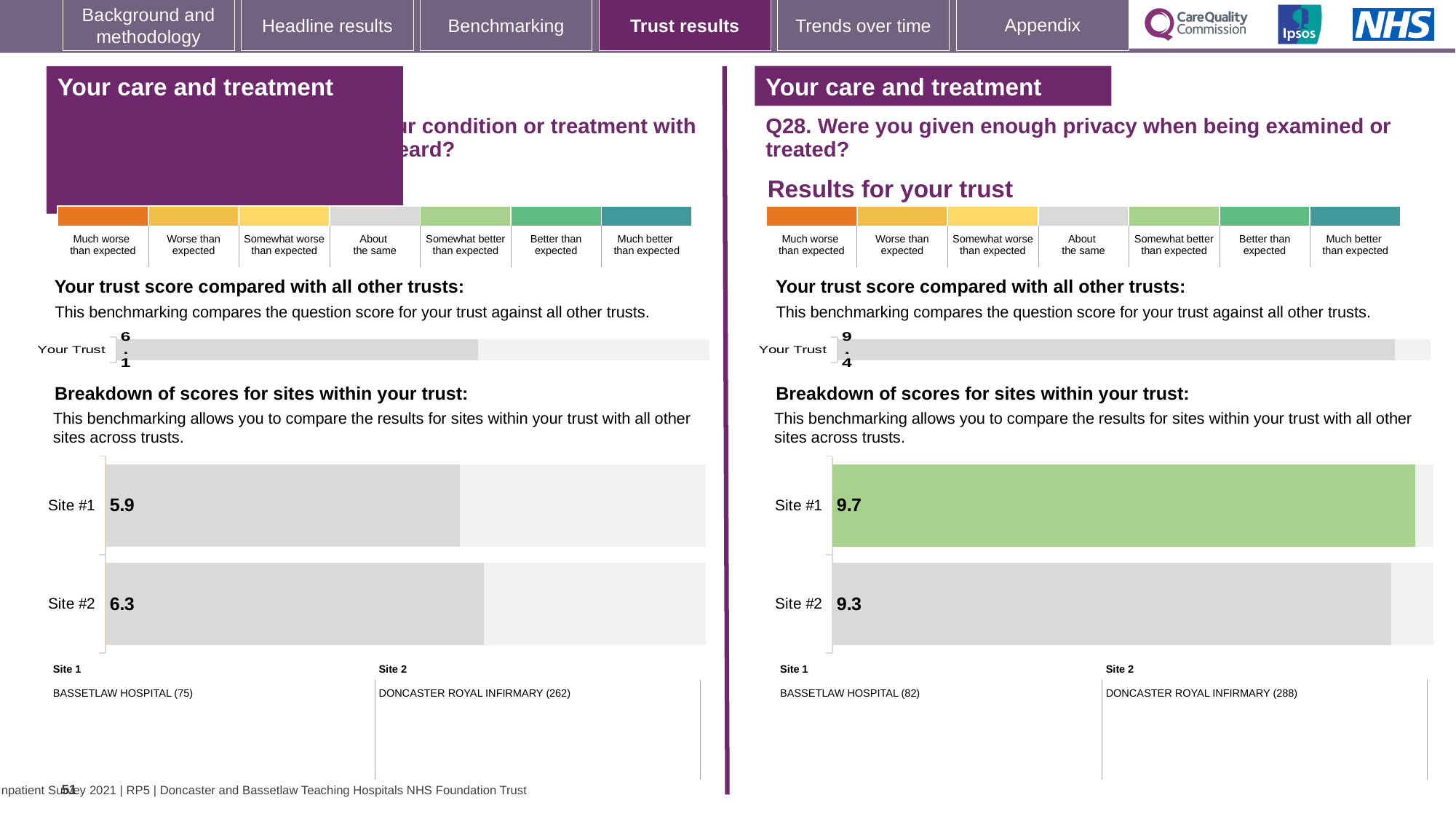
How many sites are shown in the right-hand site breakdown chart (Q28)? 2 On the left-hand site breakdown chart, what is the score for Site #2? 6.3 On the right-hand chart (Q28), what is the trust score shown for 'Your Trust'? 9.4 On the right-hand site breakdown chart (Q28), what is the score for Site #2? 9.3 On the left-hand site breakdown chart, what is the score for Site #1? 5.9 On the left-hand chart, what is the trust score shown for 'Your Trust'? 6.1 On the right-hand site breakdown chart (Q28), what is the difference between the Site #1 and Site #2 scores? 0.4 On the left-hand site breakdown chart, which site has the higher score? Site #2 On the left-hand site breakdown chart, what is the difference between the Site #2 and Site #1 scores? 0.4 On the right-hand site breakdown chart (Q28), what is the score for Site #1? 9.7 What type of chart is used for the site breakdown on the right-hand side (Q28)? Bar chart On the right-hand site breakdown chart (Q28), which site has the lower score? Site #2